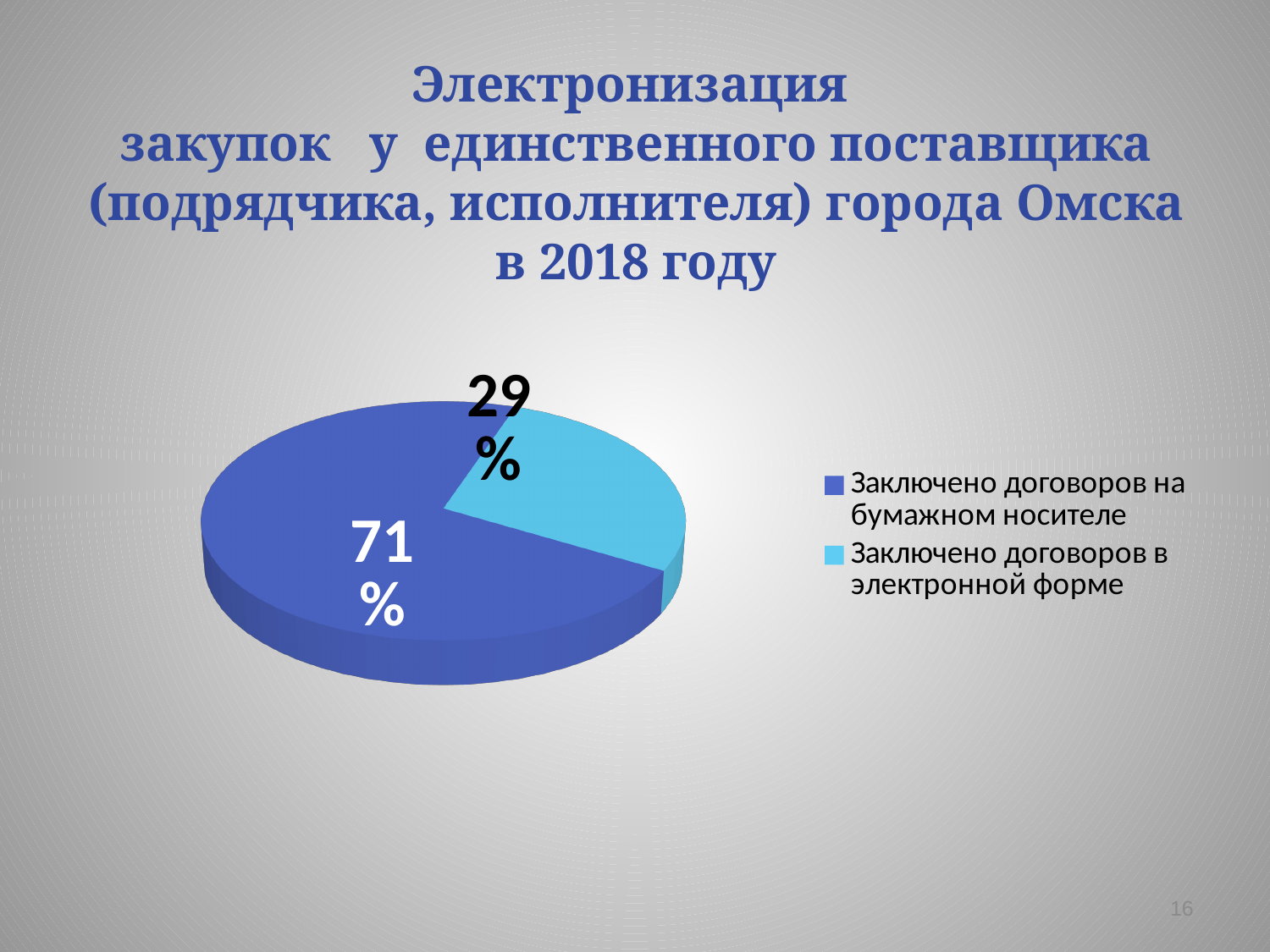
Which year does the slide title say the data refers to? 2018 Is the share of contracts concluded in electronic form greater or less than 50%? less What share of the pie is labelled "Заключено договоров на бумажном носителе"? 71% How many slices does the pie chart have? 2 What share of the pie is labelled "Заключено договоров в электронной форме"? 29% Which category has the smallest slice of the pie? Заключено договоров в электронной форме What is the difference in percentage points between the paper contracts slice and the electronic contracts slice? 42 What kind of chart is shown on the slide? pie chart Which category has the largest slice of the pie? Заключено договоров на бумажном носителе What colour is the slice for "Заключено договоров в электронной форме"? light blue Which is larger: the share of contracts concluded on paper or the share concluded in electronic form? Заключено договоров на бумажном носителе How many entries does the legend list? 2